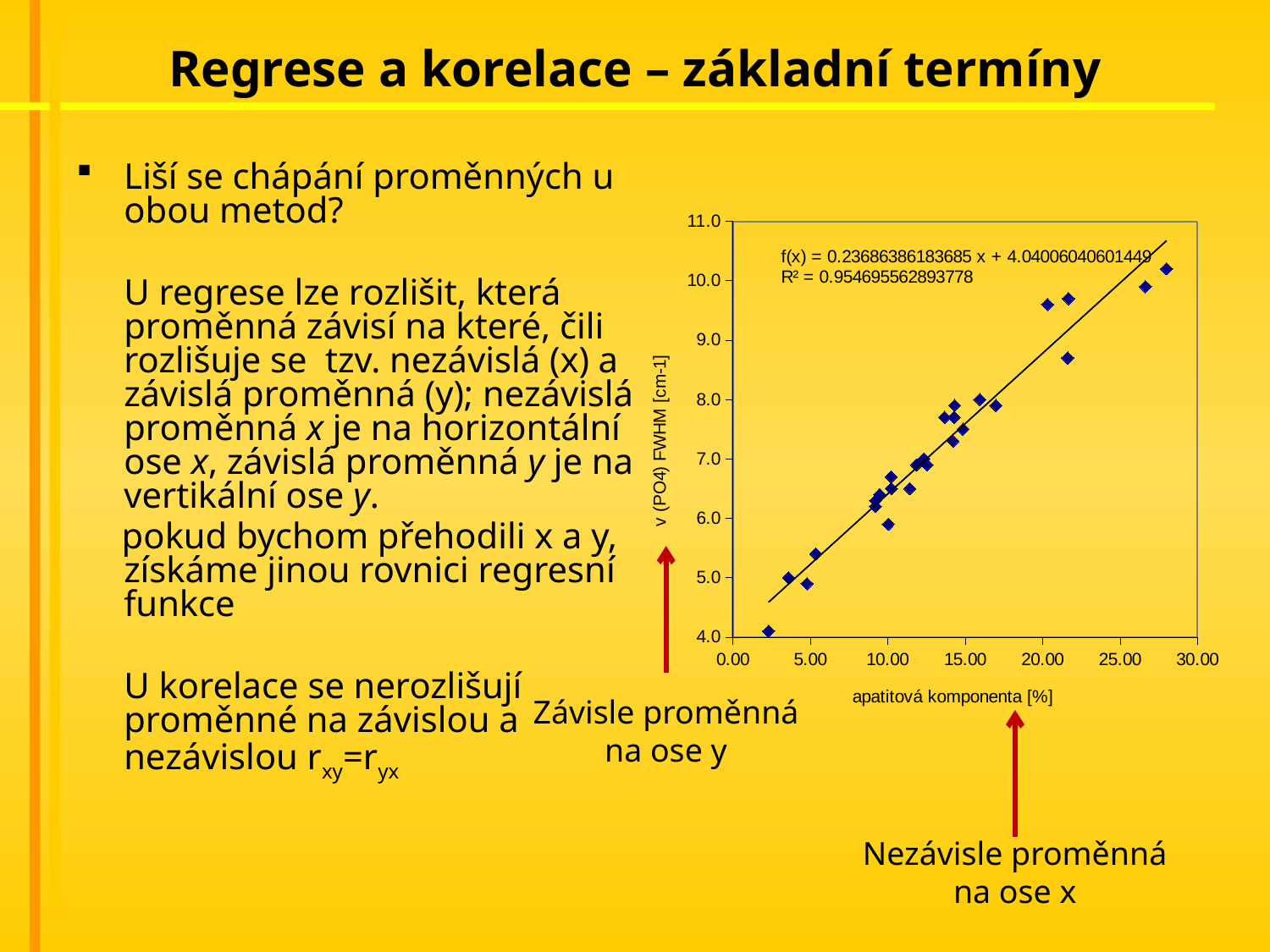
What is the regression equation f(x) printed on the chart? f(x) = 0.23686386183685 x + 4.04006040601449 What is the intercept of the fitted line shown in the equation on the chart? 4.04006040601449 What is the maximum value shown on the y axis of the chart? 11.0 What is the label of the x axis of the chart? apatitová komponenta [%] What is the label of the y axis of the chart? v (PO4) FWHM [cm-1] Is the y value of the lowest plotted point greater or less than 5.0? less What kind of chart is shown on the slide? scatter chart Is the y value of the highest plotted point greater or less than 9.0? greater What is the R² value printed on the chart? 0.954695562893778 What is the maximum value shown on the x axis of the chart? 30.00 What is the slope of the fitted line shown in the equation on the chart? 0.23686386183685 Do the plotted values rise or fall as the apatitová komponenta [%] increases along the x axis? rise